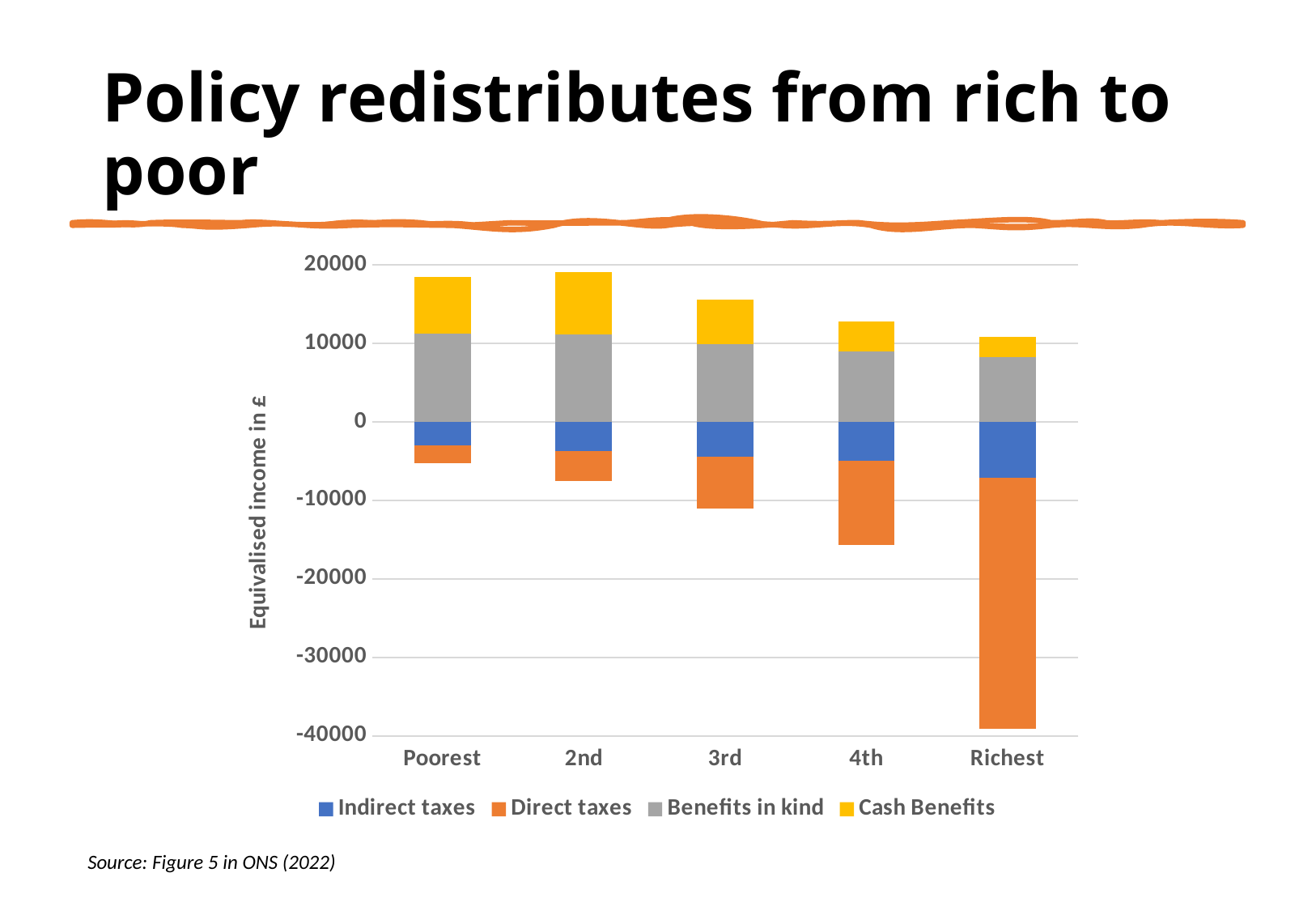
What is the label on the y axis? Equivalised income in £ Is the bottom of the Direct taxes segment for the Richest group greater or less than -30000? less Is the top of the stacked benefits for the Poorest group greater or less than 20000? less Which income group has the smallest Cash Benefits segment? Richest Which income group has the largest Direct taxes segment (furthest below zero)? Richest Is the bottom of the Direct taxes segment for the 4th group greater or less than -10000? less What kind of chart is shown on the slide? Stacked bar chart How many series does the legend list? 4 Which group has a larger Direct taxes segment, the 4th group or the 2nd group? 4th How many income groups are shown on the x axis? 5 Do the total benefits (positive stack) rise or fall moving from Poorest to Richest? Fall Which income group has the largest Indirect taxes segment? Richest